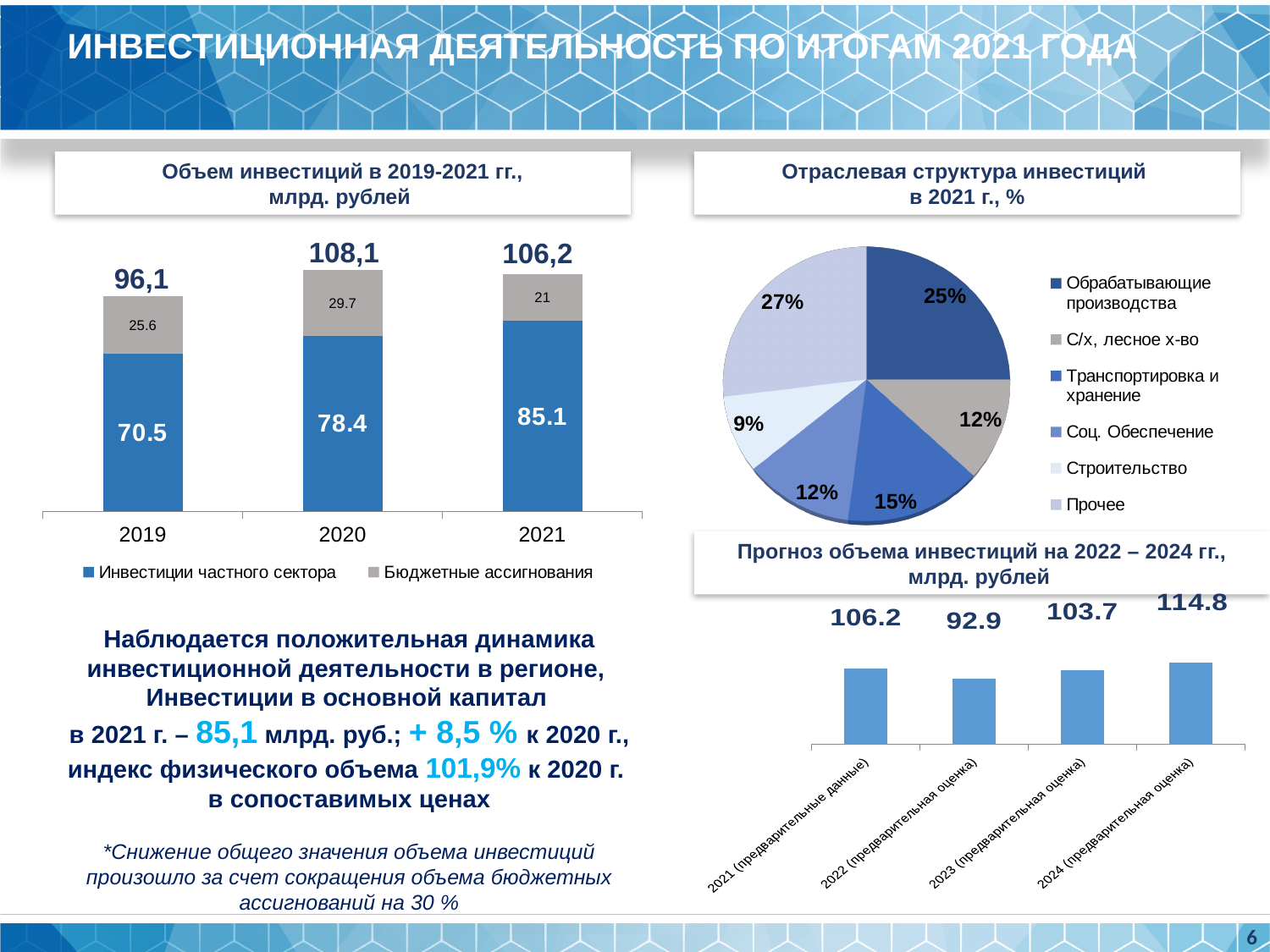
In the pie chart 'Отраслевая структура инвестиций в 2021 г., %', what share does 'Обрабатывающие производства' have? 25% In the pie chart 'Отраслевая структура инвестиций в 2021 г., %', how many categories are shown? 6 In the chart 'Объем инвестиций в 2019-2021 гг., млрд. рублей', how many series does the legend list? 2 In the chart 'Объем инвестиций в 2019-2021 гг., млрд. рублей', what is the difference between 'Инвестиции частного сектора' in 2021 and in 2020? 6.7 In the pie chart 'Отраслевая структура инвестиций в 2021 г., %', which category has the smallest share? Строительство In the chart 'Прогноз объема инвестиций на 2022 – 2024 гг., млрд. рублей', what is the value for 2024 (предварительная оценка)? 114.8 In the chart 'Объем инвестиций в 2019-2021 гг., млрд. рублей', what is the value of 'Инвестиции частного сектора' for 2021? 85.1 In the chart 'Объем инвестиций в 2019-2021 гг., млрд. рублей', what is the value of 'Бюджетные ассигнования' for 2020? 29.7 In the chart 'Объем инвестиций в 2019-2021 гг., млрд. рублей', what is the total of the stacked bar for 2019? 96,1 What kind of chart is 'Прогноз объема инвестиций на 2022 – 2024 гг., млрд. рублей'? bar chart In the chart 'Объем инвестиций в 2019-2021 гг., млрд. рублей', which year has the highest total? 2020 In the chart 'Прогноз объема инвестиций на 2022 – 2024 гг., млрд. рублей', which year has the lowest value? 2022 (предварительная оценка)